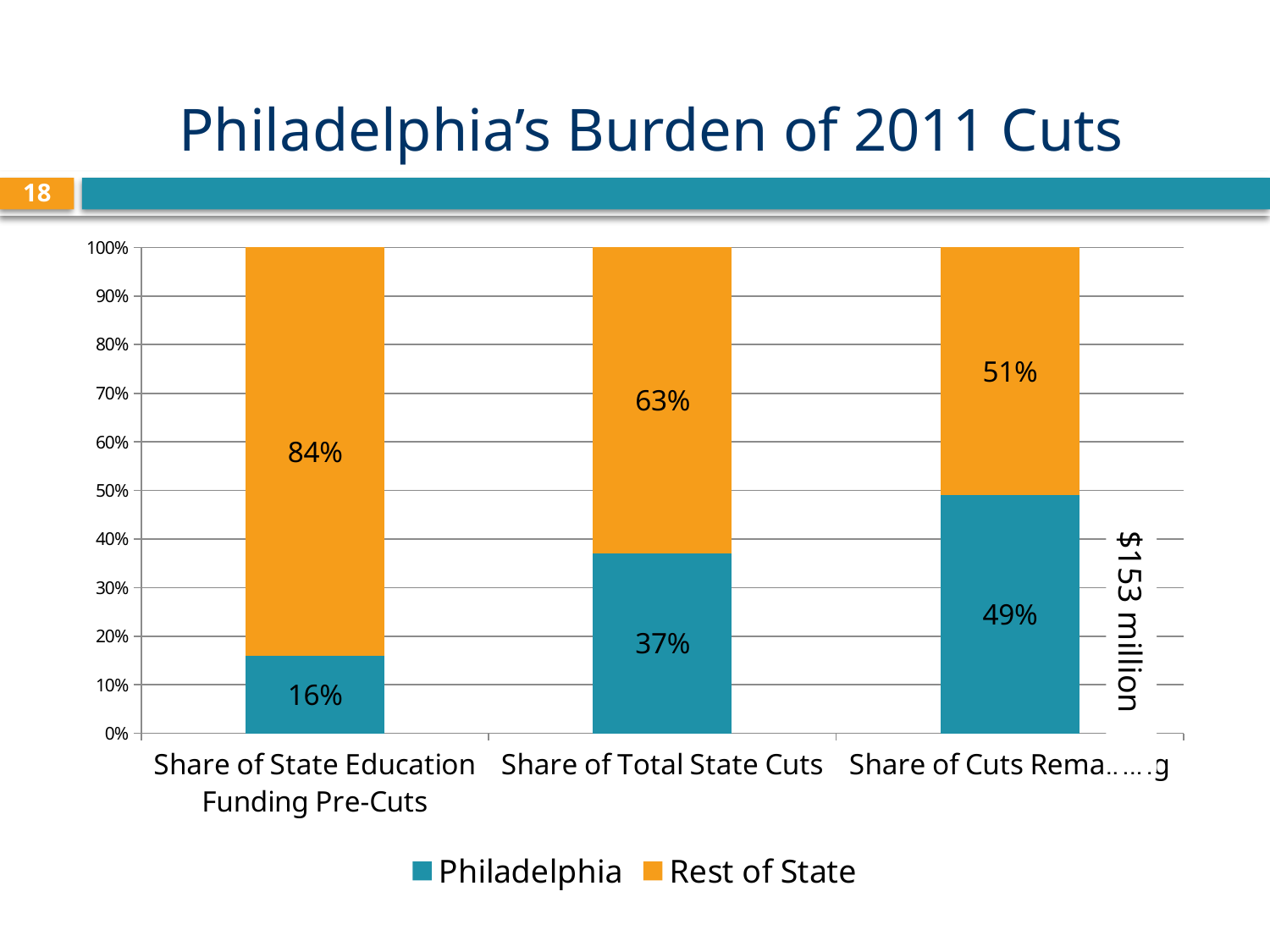
Is Philadelphia's value larger for Share of State Education Funding Pre-Cuts or for Share of Total State Cuts? Share of Total State Cuts What kind of chart is shown on the slide? Stacked bar chart Which category has the highest Rest of State value? Share of State Education Funding Pre-Cuts Which category has the lowest Philadelphia value? Share of State Education Funding Pre-Cuts Does Philadelphia's share rise or fall from left to right across the x axis? Rise How many series does the legend list? 2 For Share of State Education Funding Pre-Cuts, how much larger is the Rest of State value than the Philadelphia value? 68% What is Philadelphia's value for Share of Total State Cuts? 37% What is the Rest of State value for Share of Total State Cuts? 63% How many categories are shown on the x axis? 3 What is the Rest of State value for Share of State Education Funding Pre-Cuts? 84% What is Philadelphia's value for Share of State Education Funding Pre-Cuts? 16%